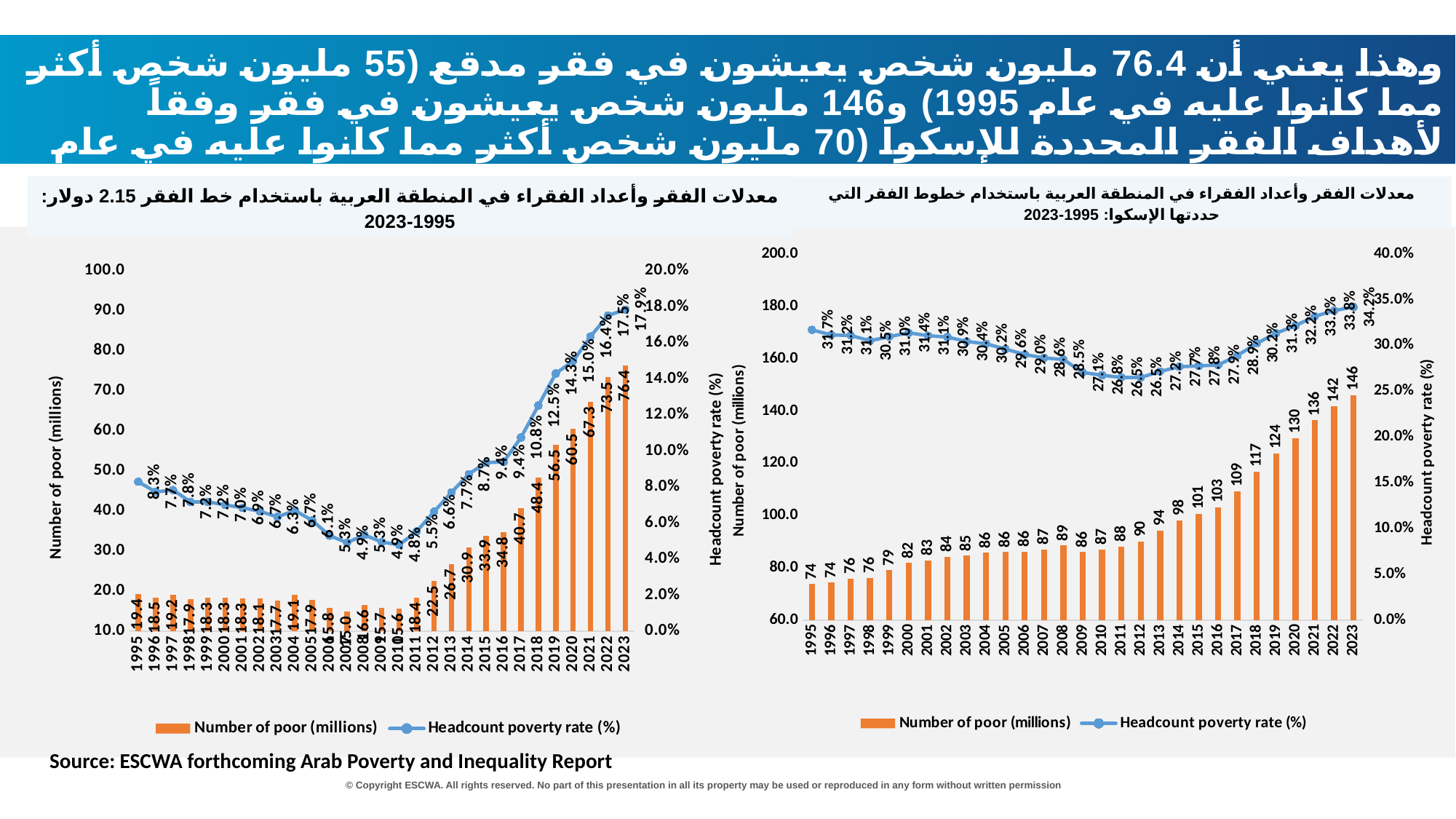
In the right chart (ESCWA poverty lines), what is the number of poor (millions) in 1995? 74 In the left chart (2.15 dollar poverty line), is the number of poor higher in 2012 or in 2004? 2012 In the left chart (2.15 dollar poverty line), what is the difference in the number of poor (millions) between 2023 and 2022? 2.9 In the left chart (2.15 dollar poverty line), what is the number of poor (millions) in 2023? 76.4 How many series does the legend of the right chart list? 2 In the right chart (ESCWA poverty lines), which year has the highest number of poor? 2023 How many years are plotted on the x axis of the left chart? 29 In the left chart (2.15 dollar poverty line), which year has the lowest headcount poverty rate? 2010 What kind of chart is the right chart (ESCWA poverty lines)? Combined bar and line chart In the right chart (ESCWA poverty lines), what is the difference in the number of poor (millions) between 2023 and 1995? 72 In the right chart (ESCWA poverty lines), what is the headcount poverty rate in 2023? 34.2% In the right chart (ESCWA poverty lines), does the number of poor rise or fall from 2012 to 2023? Rise